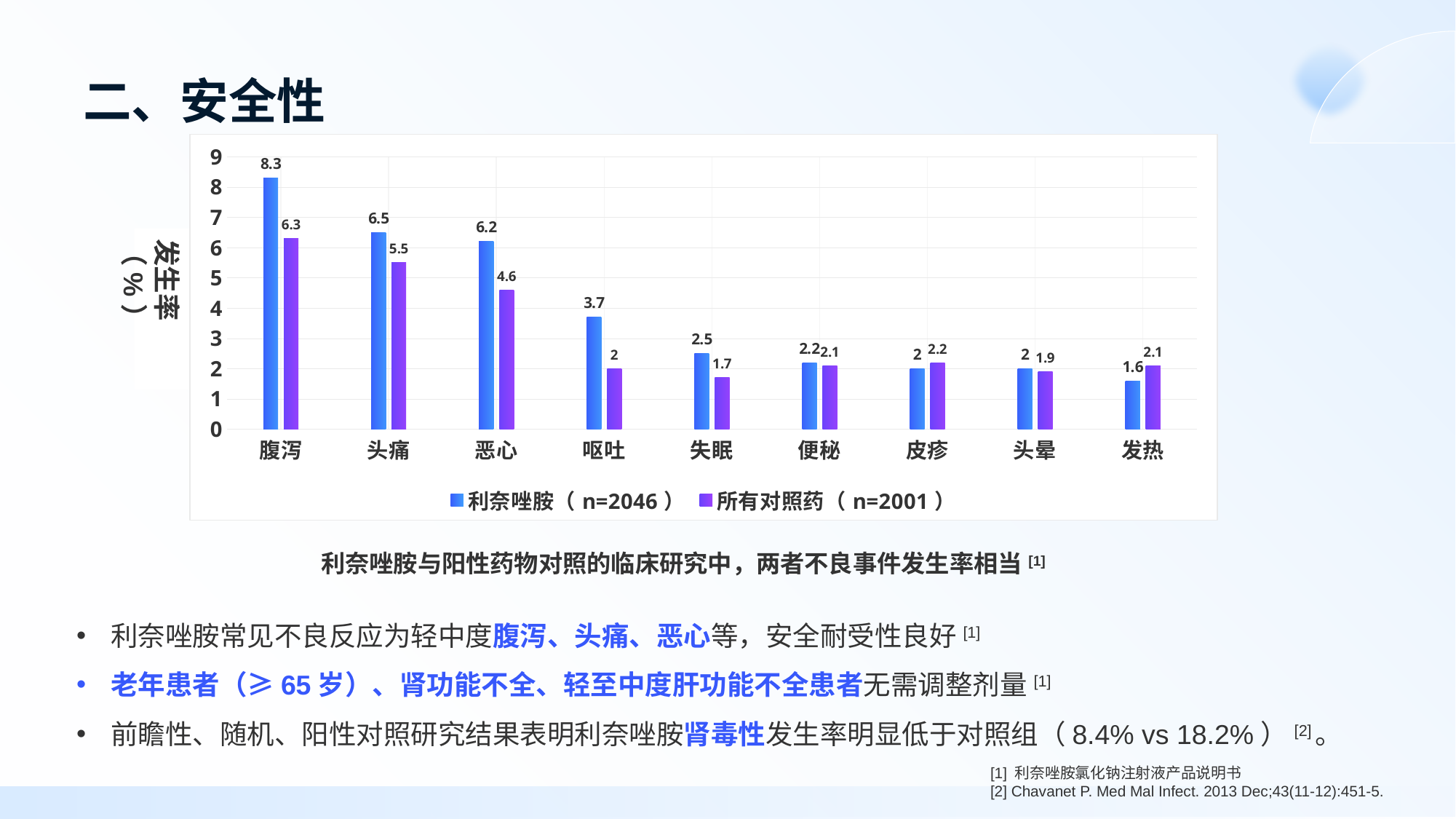
Is the value for 失眠 in the 利奈唑胺（n=2046） series greater or less than 2? greater What kind of chart is shown on the slide? bar chart Which adverse event has the lowest incidence rate for 利奈唑胺（n=2046）? 发热 What is the incidence rate of 恶心 for 所有对照药（n=2001）? 4.6 How many adverse event categories are shown on the x axis? 9 How many series does the legend list? 2 What is the value for 呕吐 in the 所有对照药（n=2001） series? 2 Which adverse event has the highest incidence rate for 利奈唑胺（n=2046）? 腹泻 What is the y-axis label of the chart? 发生率（%） For 发热, which series has the larger value, 利奈唑胺（n=2046） or 所有对照药（n=2001）? 所有对照药（n=2001） What is the difference between the 利奈唑胺 and 所有对照药 values for 头痛? 1 What is the incidence rate of 腹泻 for 利奈唑胺（n=2046）? 8.3